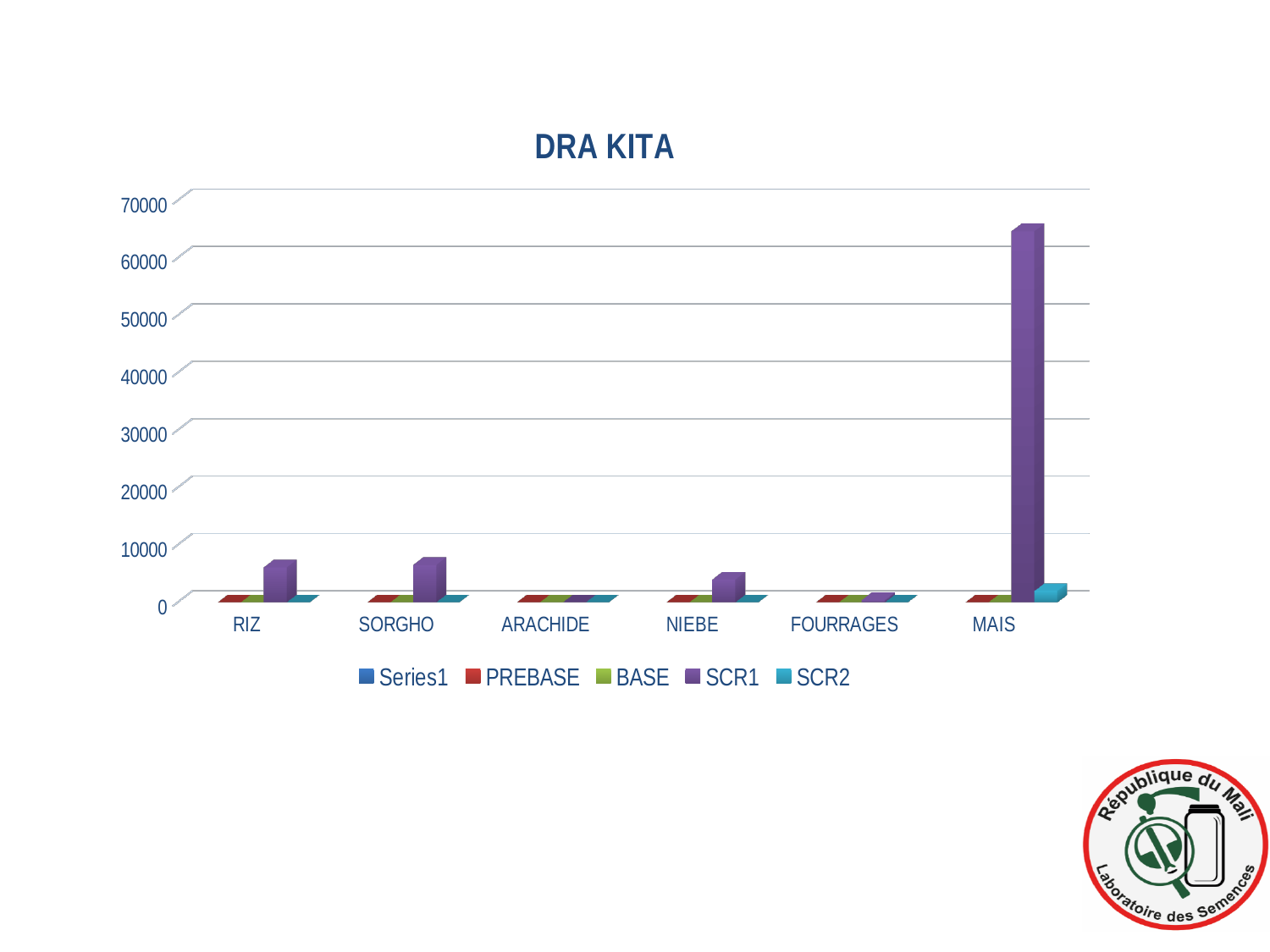
What is the title of the chart? DRA KITA What kind of chart is shown on the slide? bar chart Which has the larger SCR1 value, SORGHO or NIEBE? SORGHO Which has the larger SCR1 value, MAIS or RIZ? MAIS What colour represents the SCR1 series in the legend? purple Which category has the highest SCR1 value? MAIS Is the SCR1 value for MAIS greater or less than 60000? greater How many categories are shown on the x axis of the chart? 6 Is the SCR1 value for NIEBE greater or less than 10000? less Is the SCR1 value for RIZ greater or less than 10000? less How many series does the legend list? 5